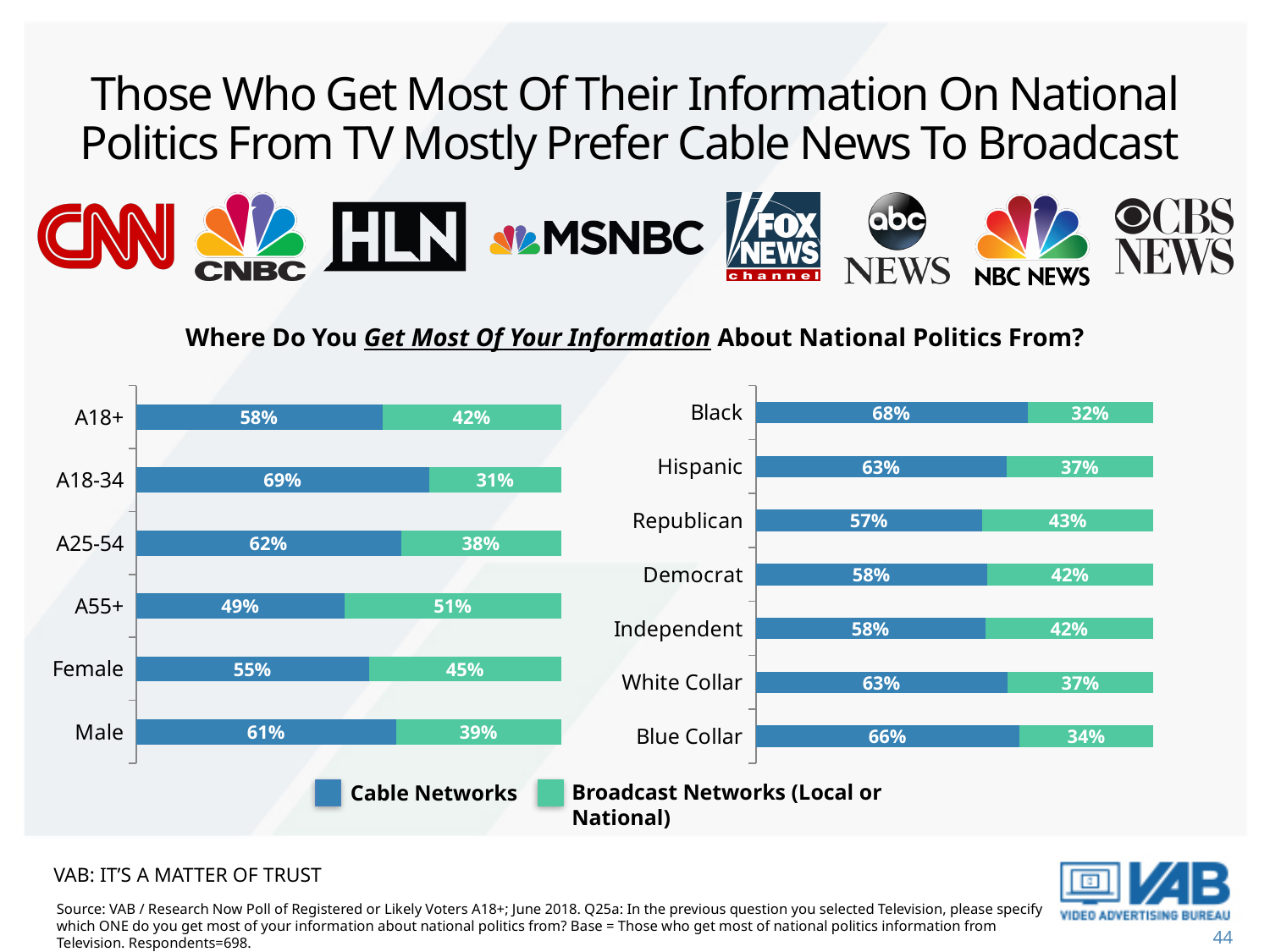
On the left chart, which category has the highest Cable Networks value? A18-34 On the left chart, what is the Broadcast Networks (Local or National) value for A55+? 51% On the left chart, what is the total of the stacked bar for A25-54? 100% On the right chart, what is the Broadcast Networks (Local or National) value for Republican? 43% On the right chart, what is the Cable Networks value for Black respondents? 68% How many categories are shown on the right chart? 7 On the left chart, what is the difference between the Cable Networks values for Male and Female? 6% What type of chart is used on the left side of the slide? Stacked bar chart On the left chart, what percentage of A18-34 get most of their national politics information from Cable Networks? 69% On the right chart, which has a larger Cable Networks value, Blue Collar or White Collar? Blue Collar On the right chart, which category has the lowest Cable Networks value? Republican How many series does the legend list? 2